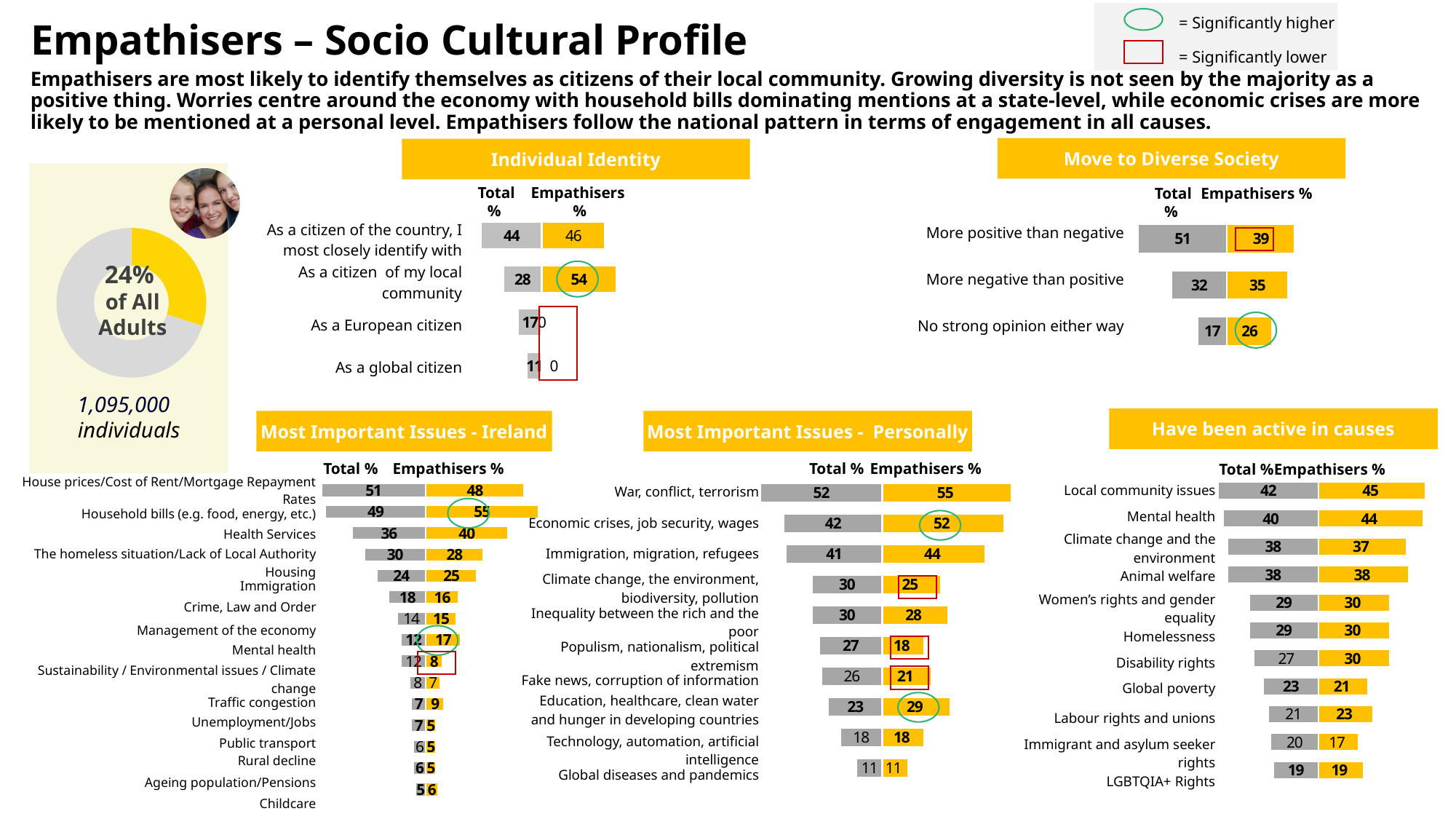
In the 'Most Important Issues - Ireland' chart, what is the Empathisers % for 'Household bills (e.g. food, energy, etc.)'? 55 What percentage of all adults does the donut chart on the left show for Empathisers? 24% How many categories are shown in the 'Move to Diverse Society' chart? 3 In the 'Most Important Issues - Personally' chart, which issue has the highest Empathisers %? War, conflict, terrorism In the 'Move to Diverse Society' chart, what is the Empathisers % for 'More positive than negative'? 39 In the 'Have been active in causes' chart, which cause has the highest Empathisers %? Local community issues In the 'Move to Diverse Society' chart, which is larger for 'No strong opinion either way': the Total % or the Empathisers %? Empathisers % In the 'Most Important Issues - Personally' chart, what is the Total % for 'Economic crises, job security, wages'? 42 In the 'Individual Identity' chart, what is the difference between the Empathisers % and the Total % for 'As a citizen of my local community'? 26 In the 'Individual Identity' chart, what is the Empathisers % for 'As a citizen of my local community'? 54 In the 'Most Important Issues - Personally' chart, which issue has the lowest Empathisers %? Global diseases and pandemics In the 'Have been active in causes' chart, what is the Empathisers % for 'Mental health'? 44